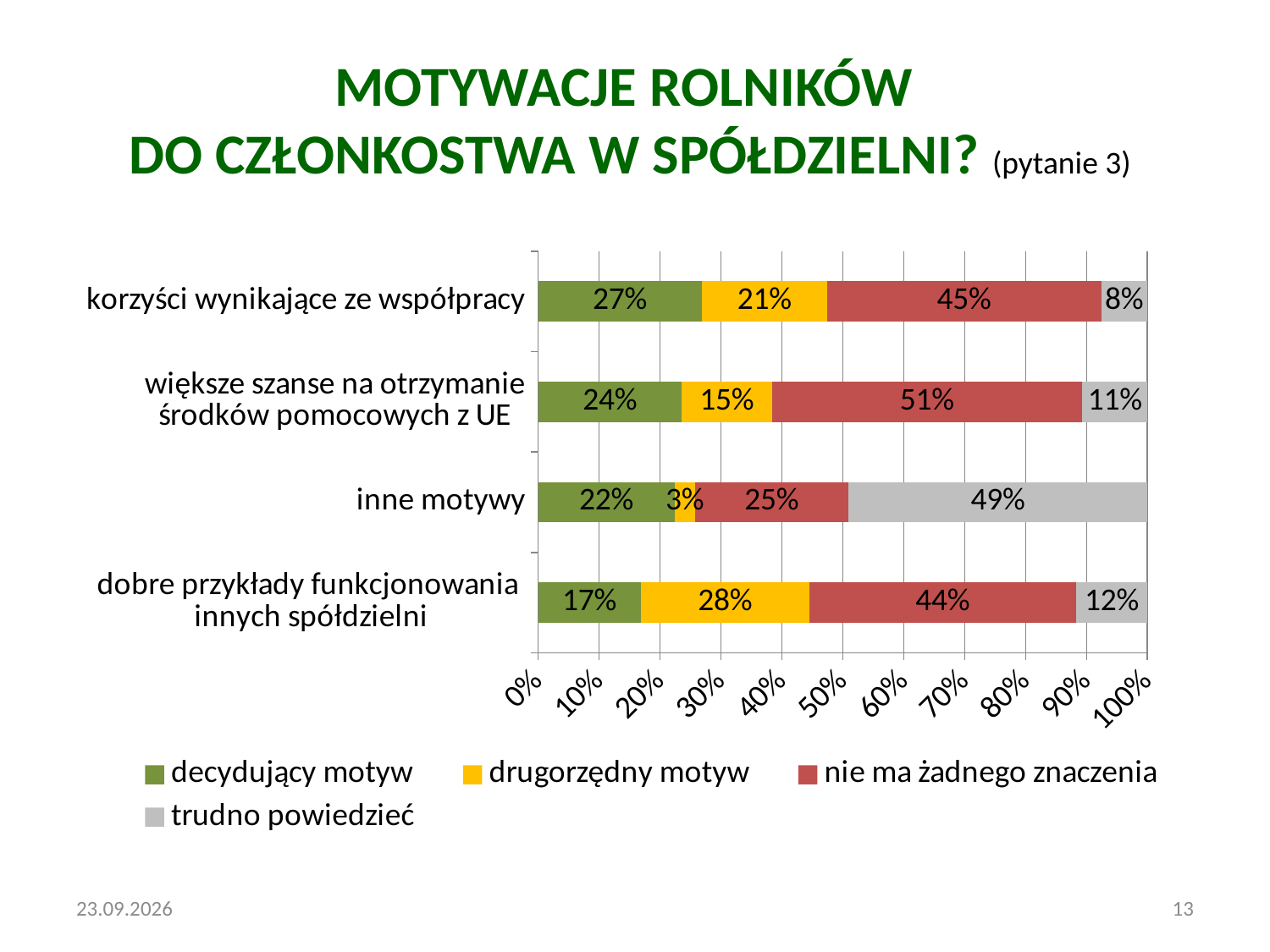
Which category has the lowest value for 'drugorzędny motyw'? inne motywy Which category has the highest value for 'decydujący motyw'? korzyści wynikające ze współpracy How many categories are shown on the chart? 4 What kind of chart is shown on the slide? stacked bar chart What is the value of 'drugorzędny motyw' for 'dobre przykłady funkcjonowania innych spółdzielni'? 28% How many series does the legend list? 4 What is the value of 'nie ma żadnego znaczenia' for 'większe szanse na otrzymanie środków pomocowych z UE'? 51% Which is larger: the 'trudno powiedzieć' value for 'korzyści wynikające ze współpracy' or for 'dobre przykłady funkcjonowania innych spółdzielni'? dobre przykłady funkcjonowania innych spółdzielni What is the value of 'decydujący motyw' for 'korzyści wynikające ze współpracy'? 27% Which colour represents 'nie ma żadnego znaczenia' in the legend? red What is the value of 'trudno powiedzieć' for 'inne motywy'? 49% What is the difference between the 'nie ma żadnego znaczenia' values for 'większe szanse na otrzymanie środków pomocowych z UE' and 'inne motywy'? 26%